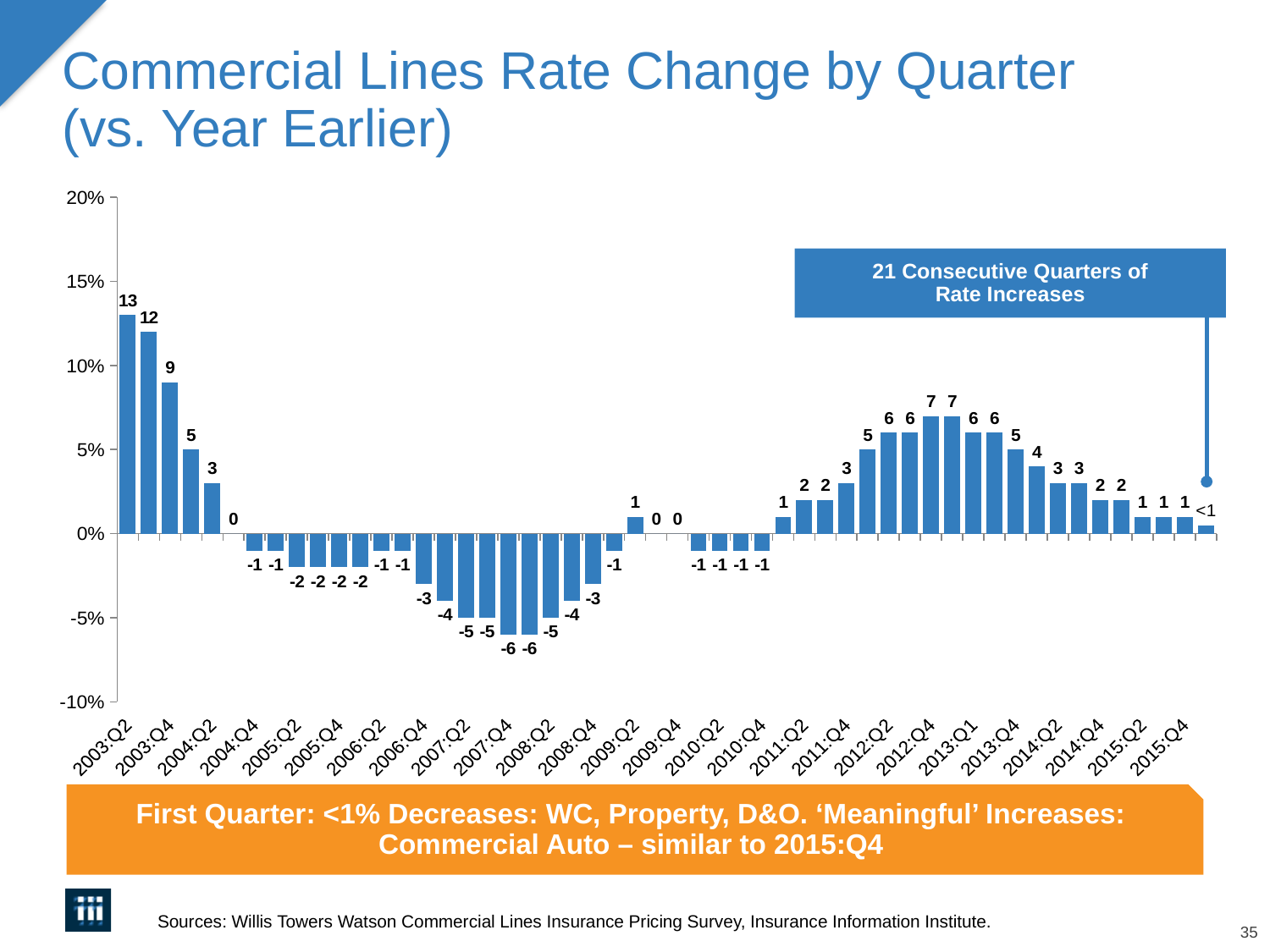
What is the lowest rate change value shown in the chart? -6 What does the blue callout box on the chart say? 21 Consecutive Quarters of Rate Increases Do the values rise or fall from 2003:Q2 to 2004:Q4? fall What is the rate change value for 2003:Q2? 13 What is the rate change value for 2003:Q4? 9 Is the value for 2003:Q2 greater or less than 10%? greater What kind of chart is shown on the slide? bar chart What is the highest value shown on the vertical axis? 20% What is the highest rate change value shown in the chart? 13 What is the data label on the last bar of the chart? <1 What is the difference between the rate change values for 2003:Q2 and 2003:Q4? 4 Which quarter has the larger rate change, 2003:Q2 or 2003:Q4? 2003:Q2